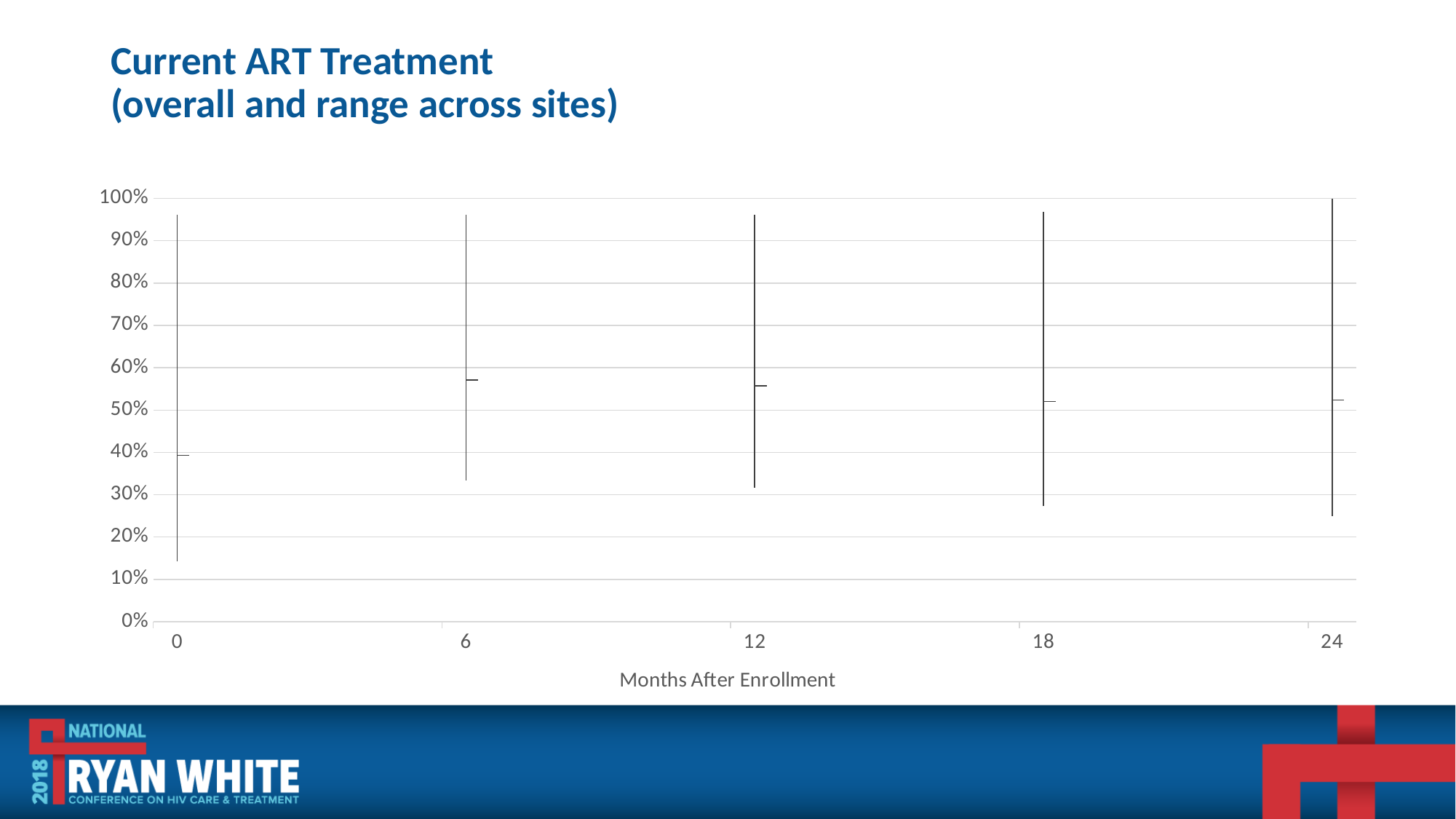
Is the lower end of the range at 0 months greater or less than 20%? less Is the overall value at 0 months greater or less than 50%? less Does the overall value rise or fall from 0 months to 6 months? rise What is the label of the x axis? Months After Enrollment At which time point is the lower end of the range across sites lowest? 0 months What is the title of the chart? Current ART Treatment (overall and range across sites) Is the overall value at 24 months greater or less than 60%? less At which time point is the overall value lowest? 0 months How many time points are plotted along the x axis? 5 Which is larger, the overall value at 0 months or at 6 months? 6 months